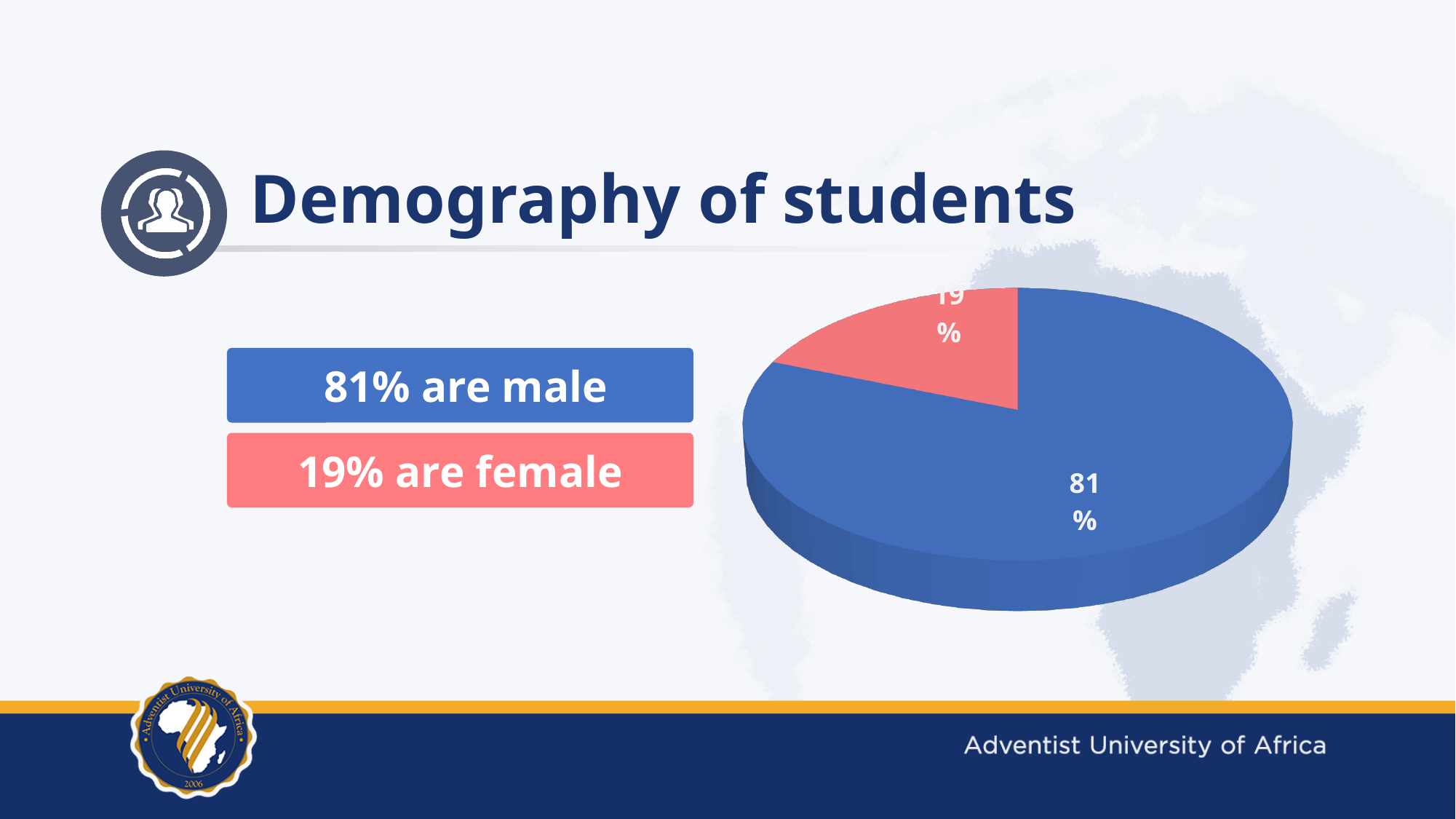
What kind of chart is shown on the slide? pie chart Which group has the larger share of the pie chart, male or female? male What is the difference in percentage points between the male and female shares? 62 What is the title of the slide containing the pie chart? Demography of students What percentage of students are male according to the pie chart? 81% What percentage of students are female according to the pie chart? 19% Is the female share larger or smaller than the male share? smaller What share of the pie does the blue slice represent? 81% How many slices does the pie chart have? 2 Which group has the smaller share of the pie chart? female What colour is the slice representing female students? red